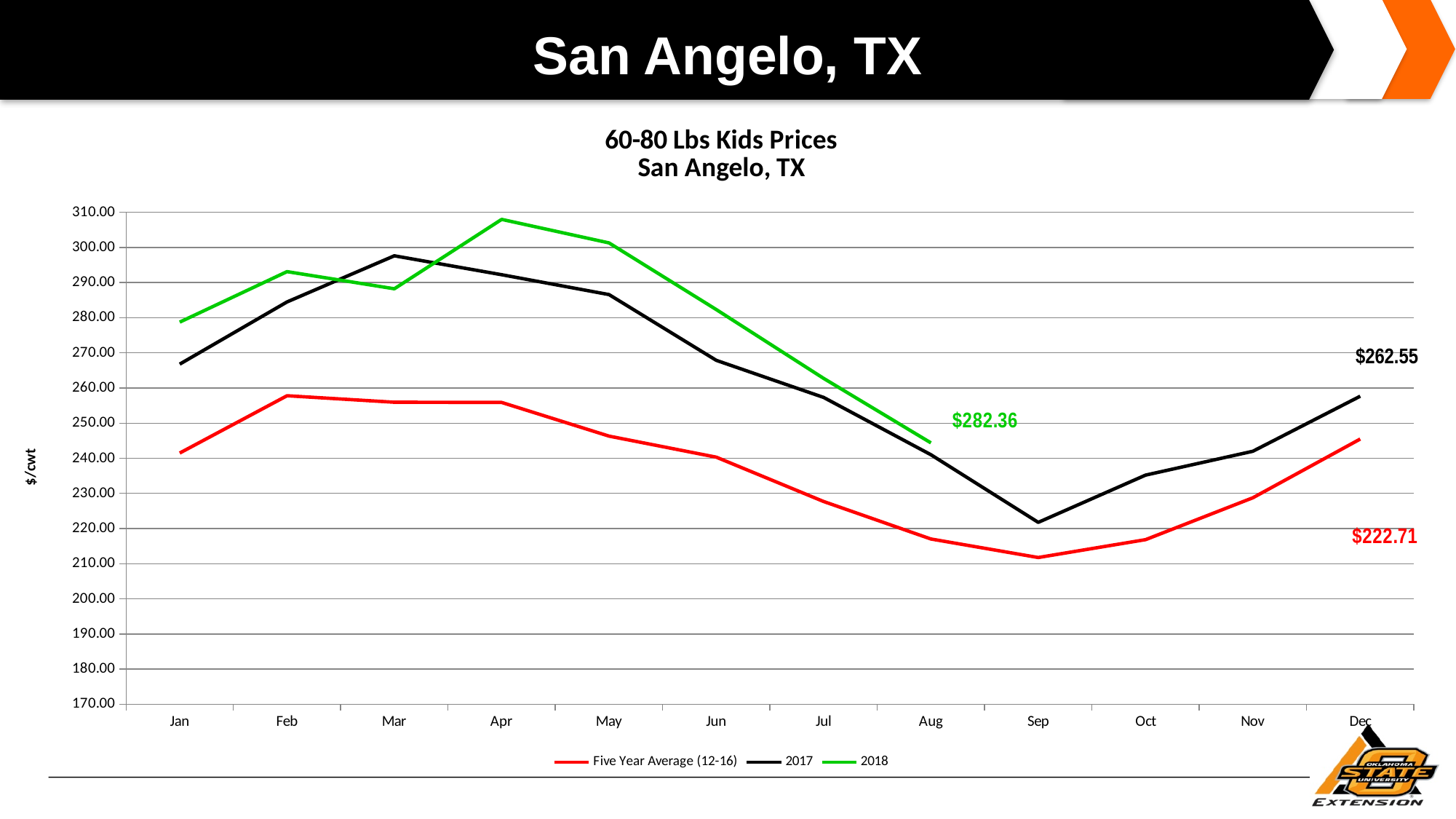
Is the 2018 value for Apr greater or less than 300.00? greater In which month does the 2017 series reach its lowest value? Sep Is the Five Year Average (12-16) value for Sep greater or less than 220.00? less What unit is shown on the y-axis label? $/cwt In which month is the Five Year Average (12-16) series at its lowest? Sep Does the 2017 series rise or fall from Sep to Dec? rise In which month does the 2018 series reach its highest value? Apr How many series does the legend list? 3 In Jan, which series is higher: 2017 or 2018? 2018 How many months are shown along the x axis? 12 What kind of chart is shown on the slide? line chart In Mar, which series is higher: 2017 or 2018? 2017